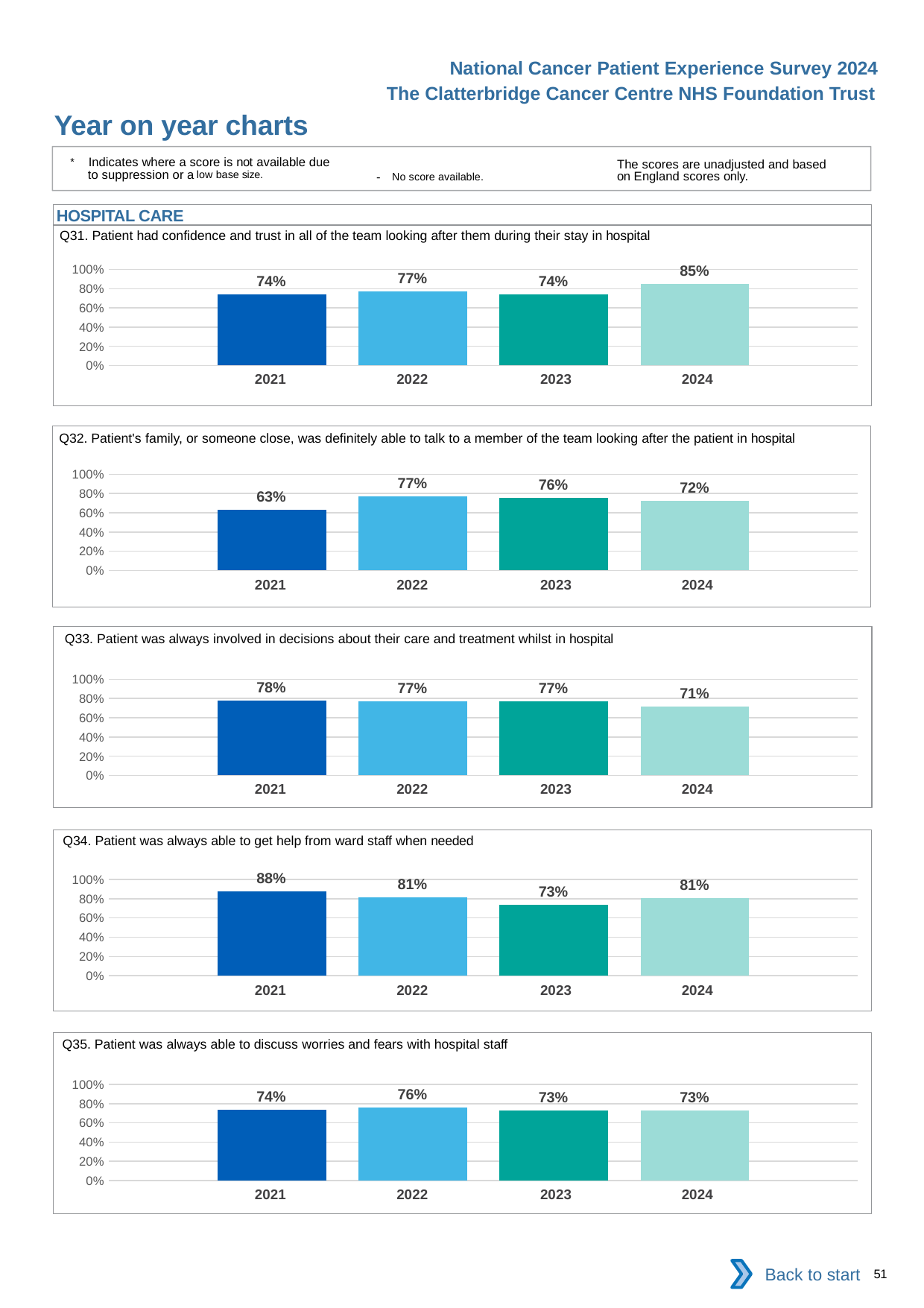
In the Q34 chart, which year has the highest value? 2021 In the Q34 chart, which is larger, the value for 2022 or the value for 2023? 2022 In the Q32 chart, what is the difference between the 2022 value and the 2021 value? 14 percentage points In the Q33 chart, what is the difference between the 2021 value and the 2024 value? 7 percentage points In the Q33 chart, do the values rise or fall from 2021 to 2024? Fall How many years are shown on the x axis of the Q31 chart? 4 In the Q32 chart, which year has the lowest value? 2021 In the Q31 chart, what is the value for 2024? 85% In the Q35 chart, what is the value for 2022? 76% In the Q34 chart, what is the value for 2021? 88% What kind of chart is the Q33 chart? Bar chart In the Q35 chart, is the value for 2023 greater or less than 80%? less